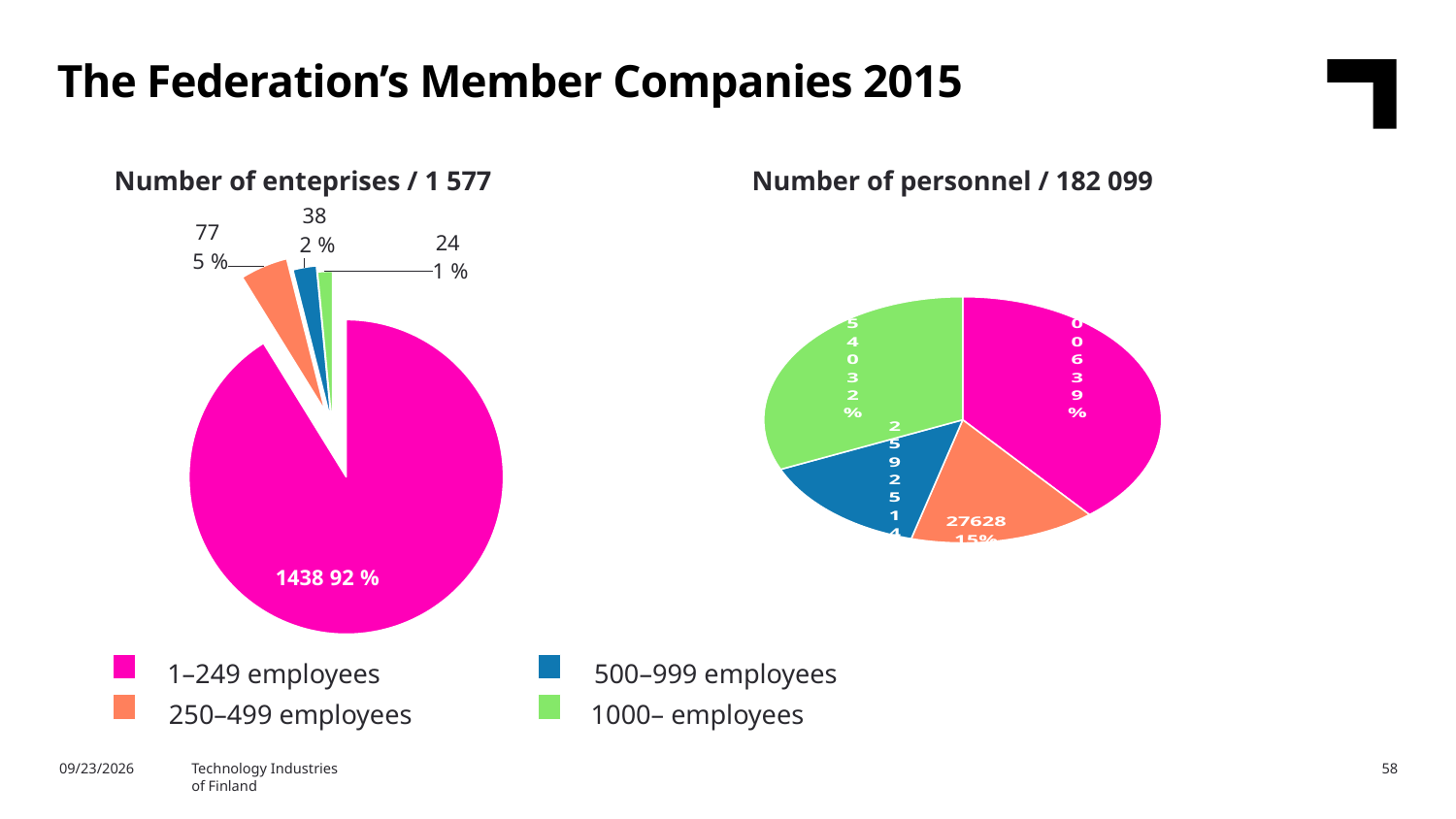
In the 'Number of enteprises / 1 577' chart, how many slices are there? 4 In the 'Number of personnel / 182 099' chart, what is the number of personnel in companies with 250–499 employees? 27628 What kind of chart is the 'Number of enteprises / 1 577' chart? pie chart In the 'Number of enteprises / 1 577' chart, what is the number of enterprises with 1–249 employees? 1438 In the 'Number of enteprises / 1 577' chart, what is the number of enterprises with 1000– employees? 24 In the 'Number of enteprises / 1 577' chart, which has more enterprises: 250–499 employees or 500–999 employees? 250–499 employees In the 'Number of enteprises / 1 577' chart, what share of enterprises have 1–249 employees? 92 % In the 'Number of enteprises / 1 577' chart, what is the number of enterprises with 250–499 employees? 77 In the 'Number of enteprises / 1 577' chart, what is the difference between the number of enterprises with 250–499 employees and those with 500–999 employees? 39 In the 'Number of enteprises / 1 577' chart, which employee size category has the fewest enterprises? 1000– employees In the 'Number of personnel / 182 099' chart, which employee size category has the largest share of personnel? 1–249 employees How many categories does the legend list for the charts? 4